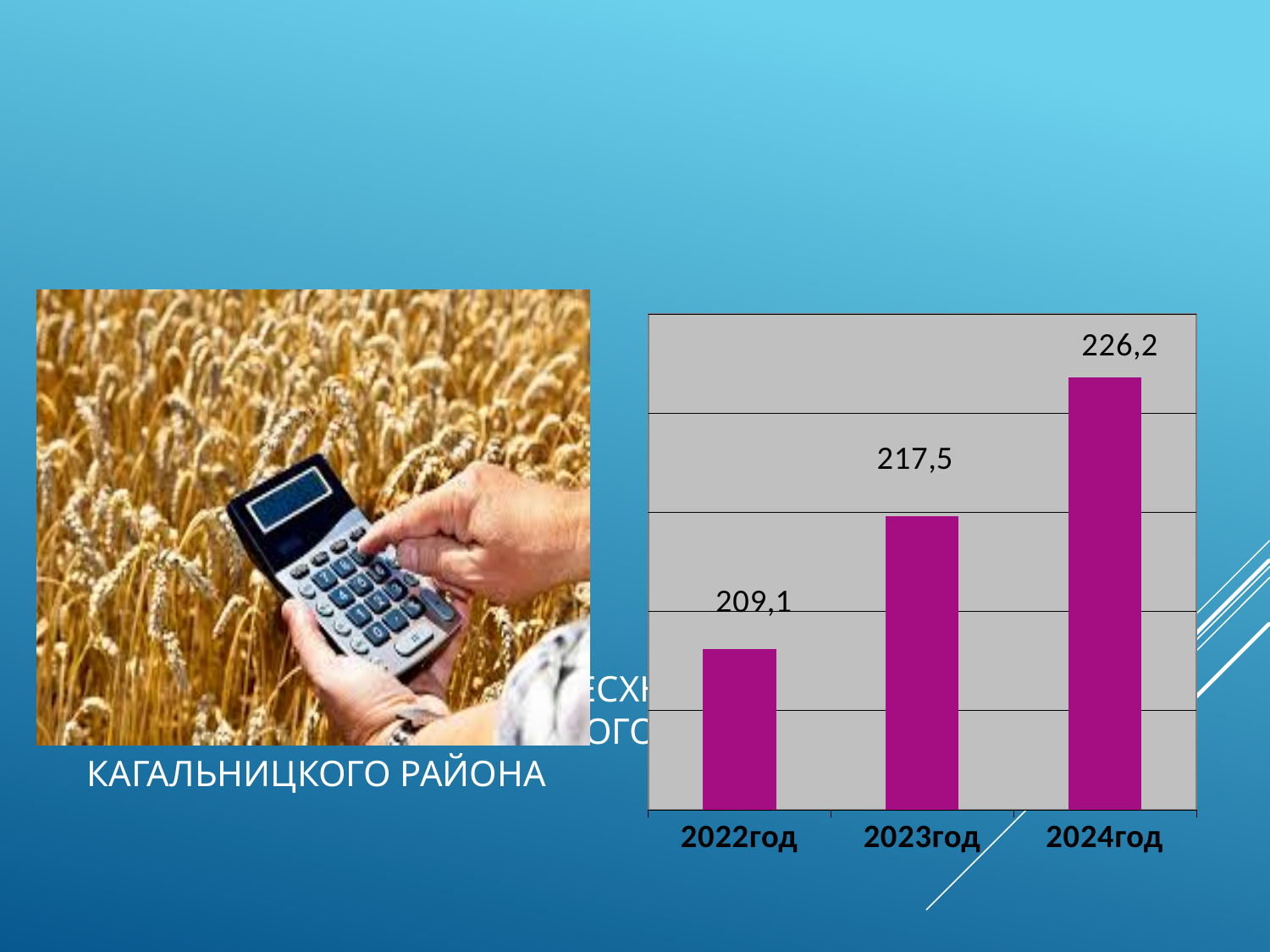
What is the value for 2022год? 209,1 What kind of chart is shown on the slide? bar chart Which is larger, the value for 2023год or the value for 2024год? 2024год What is the difference between the values for 2023год and 2022год? 8,4 What is the difference between the values for 2024год and 2022год? 17,1 What is the difference between the values for 2024год and 2023год? 8,7 How many bars are shown in the chart? 3 Which year has the lowest value? 2022год Do the values rise or fall from 2022год to 2024год? rise What is the value for 2024год? 226,2 What is the value for 2023год? 217,5 Which year has the highest value? 2024год